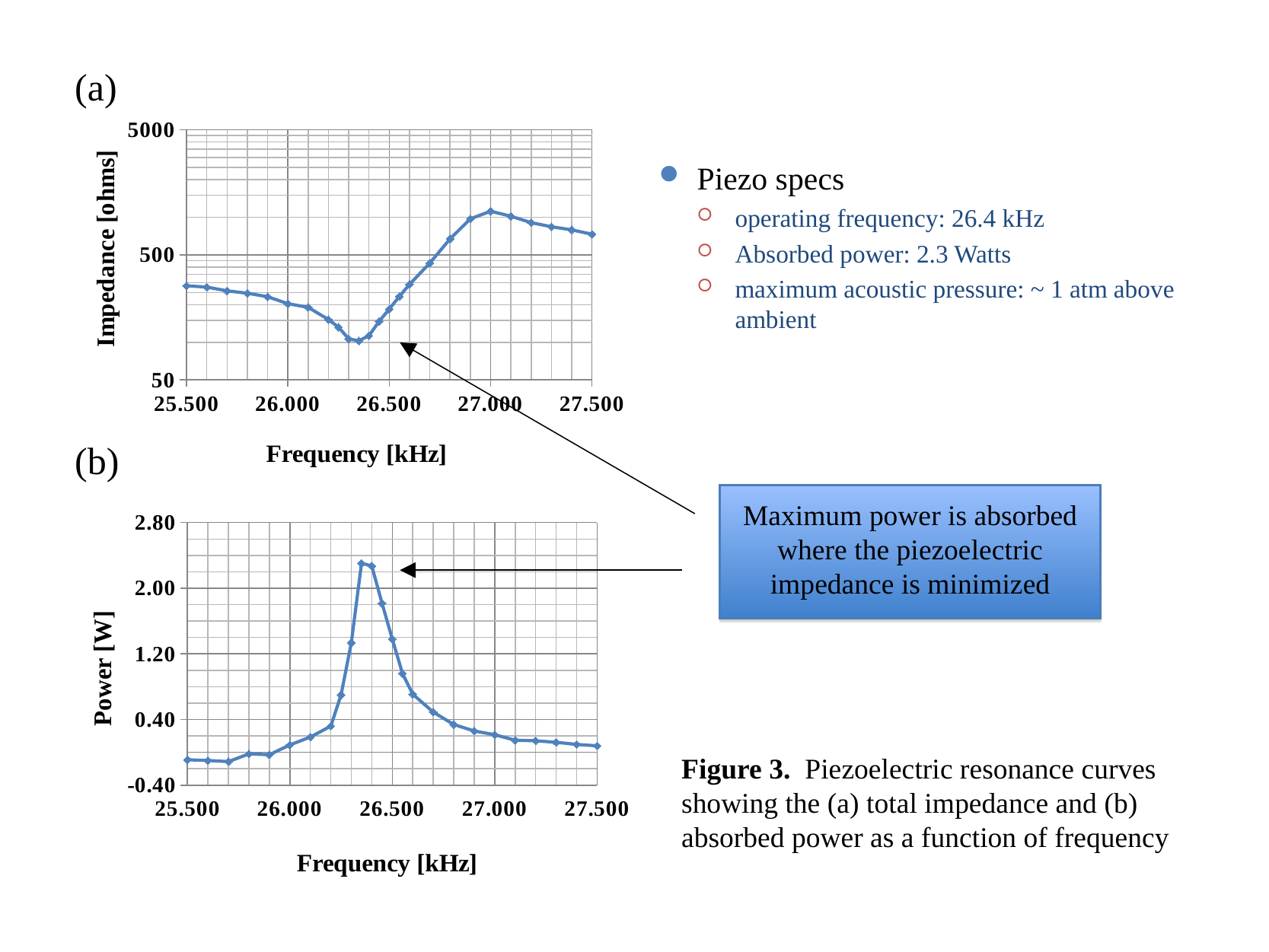
In chart (a), what is the label of the y axis? Impedance [ohms] How many charts are shown on the slide? 2 In chart (b), is the peak power greater or less than 2.00? greater What kind of chart is chart (a), Impedance vs Frequency? line chart In chart (a), is the impedance at 27.000 kHz greater or less than 500? greater In chart (b), what is the label of the y axis? Power [W] In chart (b), is the power at 25.500 kHz greater or less than 0.40? less In chart (a), does the impedance rise or fall as frequency increases from 25.500 kHz to 26.000 kHz? fall In chart (b), does the power rise or fall as frequency increases from 26.500 kHz to 27.500 kHz? fall What kind of chart is chart (b), Power vs Frequency? line chart